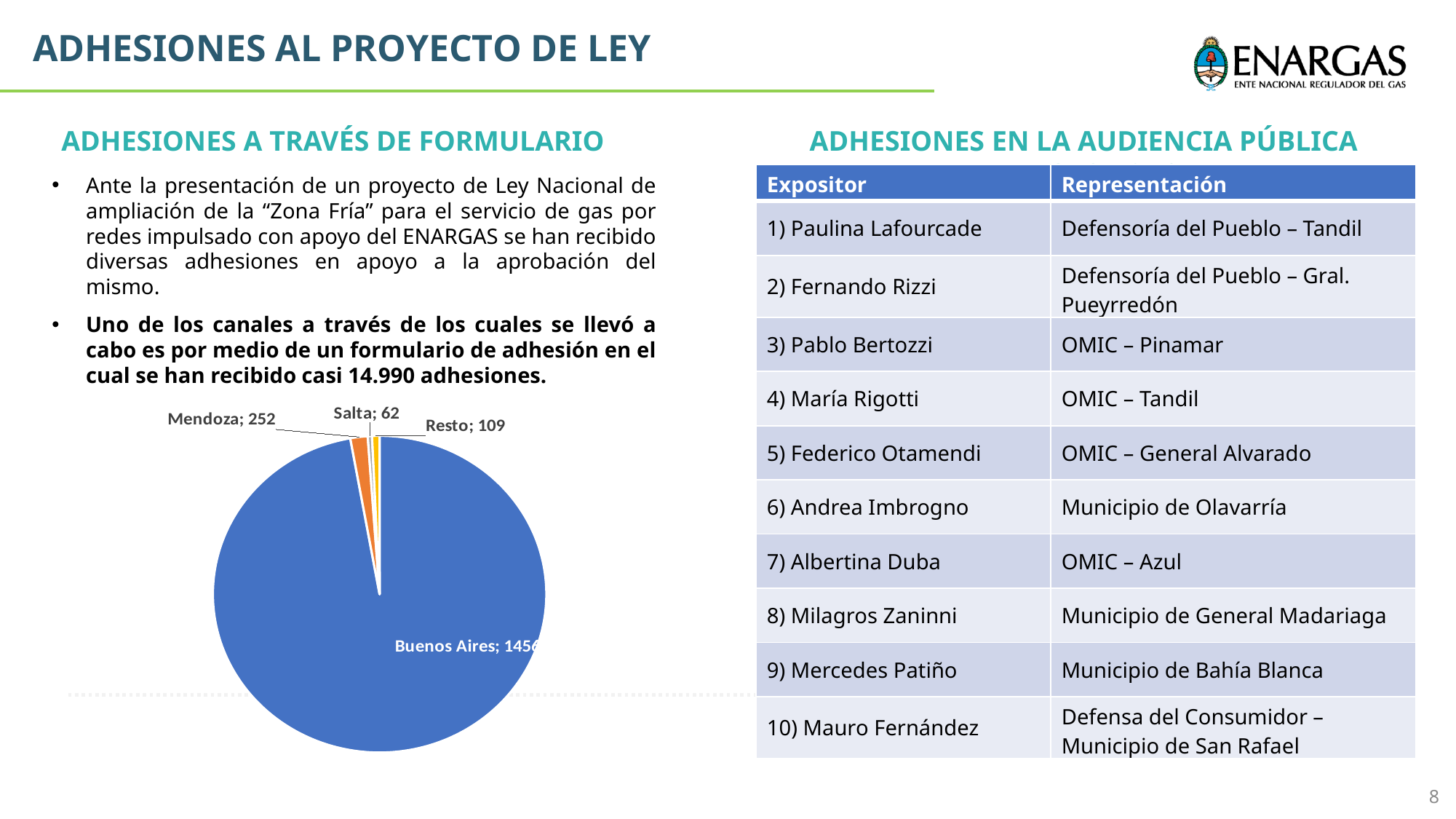
What kind of chart is shown on the slide? pie chart What is the value for Resto in the pie chart? 109 What is the difference between the values for Mendoza and Resto? 143 Which category has the smallest slice in the pie chart? Salta What is the difference between the values for Resto and Salta? 47 What is the difference between the values for Mendoza and Salta? 190 Which category has the largest slice in the pie chart? Buenos Aires What colour is the Buenos Aires slice in the pie chart? blue How many slices does the pie chart have? 4 Which is larger, the value for Resto or the value for Salta? Resto What is the value for Salta in the pie chart? 62 What is the value for Mendoza in the pie chart? 252